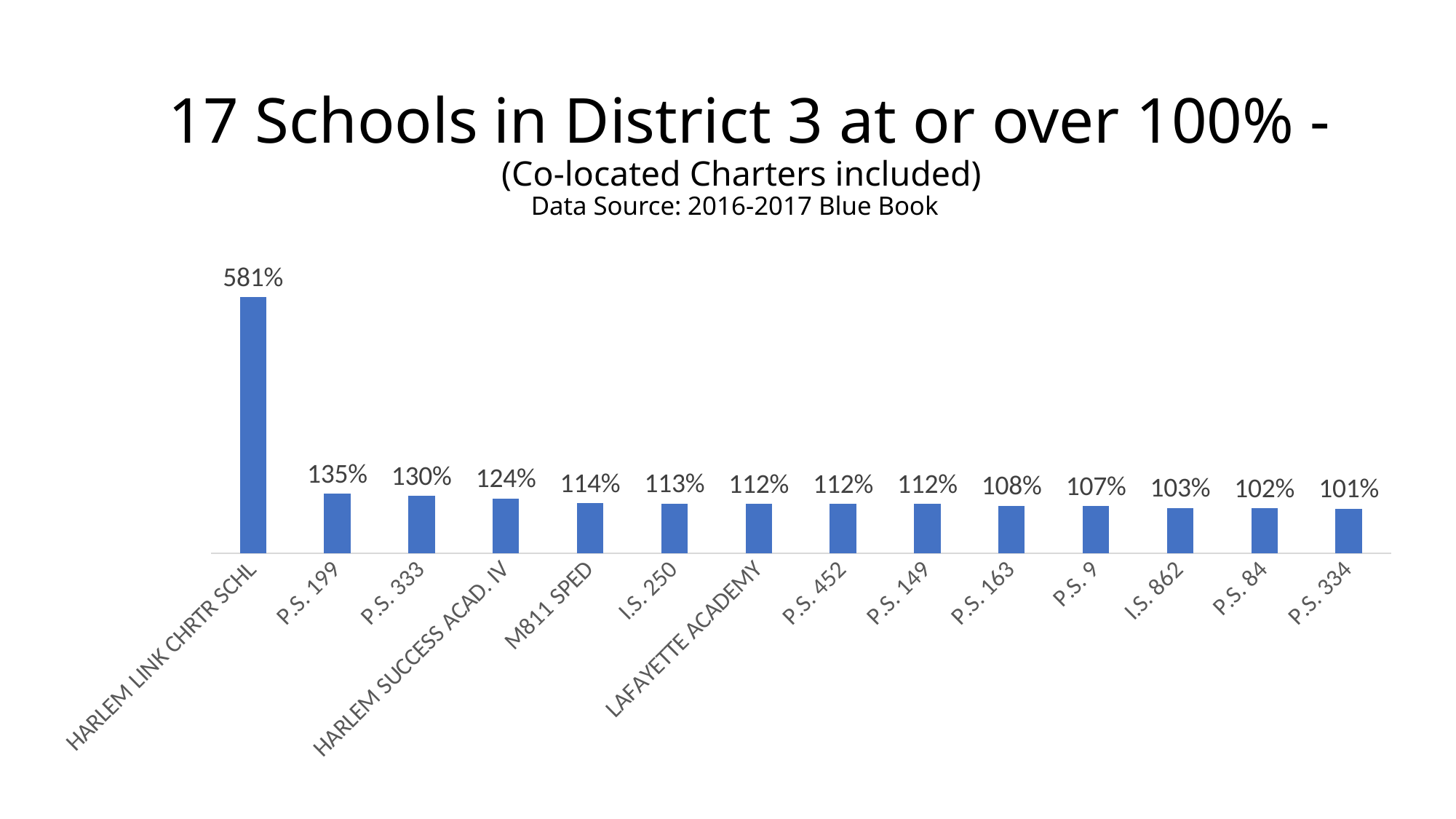
What is the value for I.S. 862? 103% Which school has the highest value? HARLEM LINK CHRTR SCHL What is the value for P.S. 199? 135% What is the difference between the values for HARLEM LINK CHRTR SCHL and P.S. 334? 480% How many bars are plotted in the chart? 14 What is the difference between the values for P.S. 199 and P.S. 333? 5% What kind of chart is shown on the slide? Bar chart What is the value for M811 SPED? 114% Which has a larger value, HARLEM SUCCESS ACAD. IV or P.S. 163? HARLEM SUCCESS ACAD. IV What is the value for HARLEM LINK CHRTR SCHL? 581% What is the value for LAFAYETTE ACADEMY? 112% Which school has the lowest value? P.S. 334